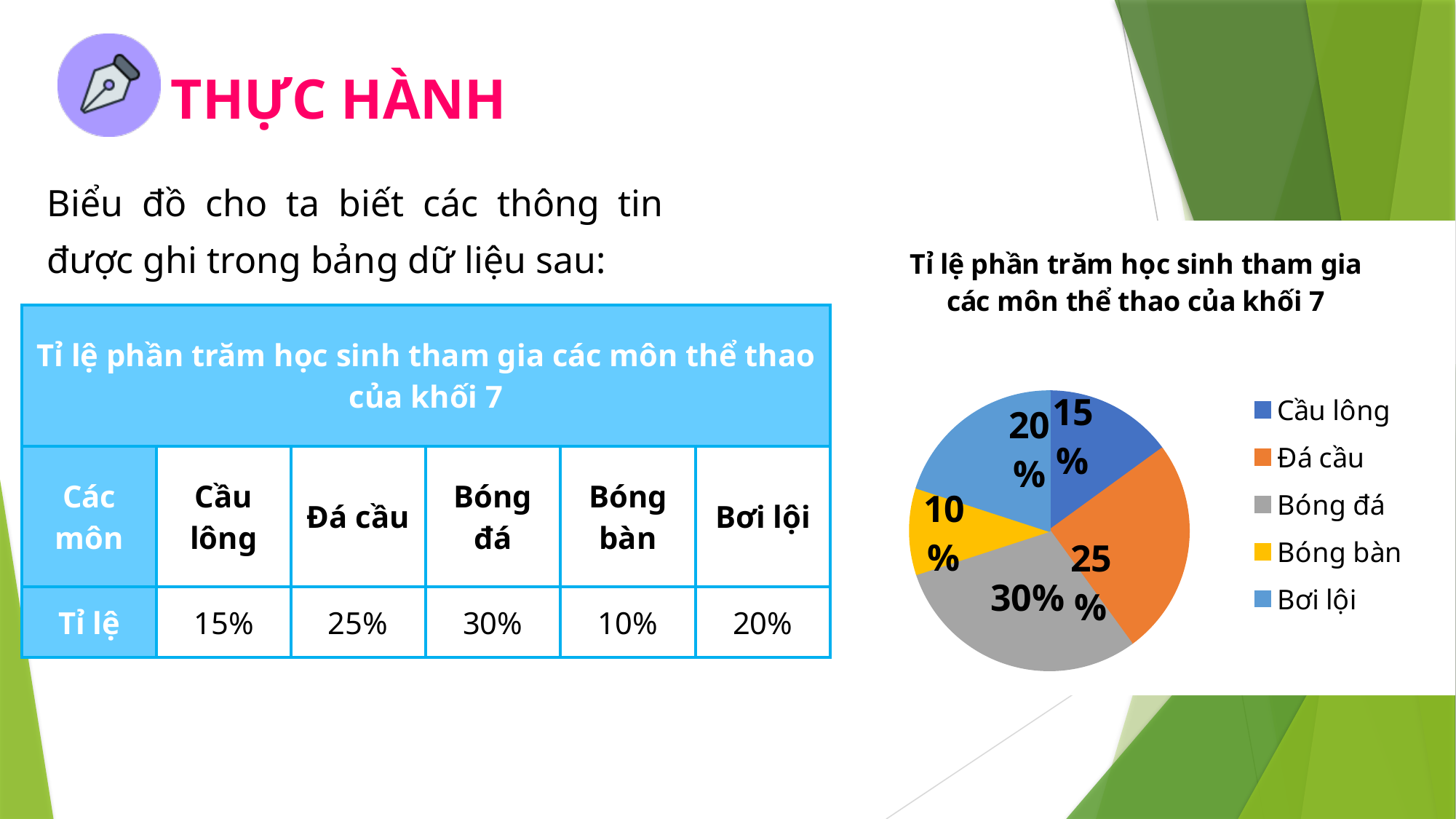
What is the difference in percentage points between Bóng đá and Cầu lông? 15% Which has a larger share, Đá cầu or Bơi lội? Đá cầu What percentage of the pie chart is Bóng đá? 30% Which sport has the smallest share of the pie chart? Bóng bàn What is the title of the pie chart? Tỉ lệ phần trăm học sinh tham gia các môn thể thao của khối 7 How many categories does the pie chart legend list? 5 Which sport has the largest share of the pie chart? Bóng đá What percentage of the pie chart is Đá cầu? 25% What percentage of the pie chart is Cầu lông? 15% What percentage of the pie chart is Bơi lội? 20% What type of chart is shown on the slide? pie chart What percentage of the pie chart is Bóng bàn? 10%